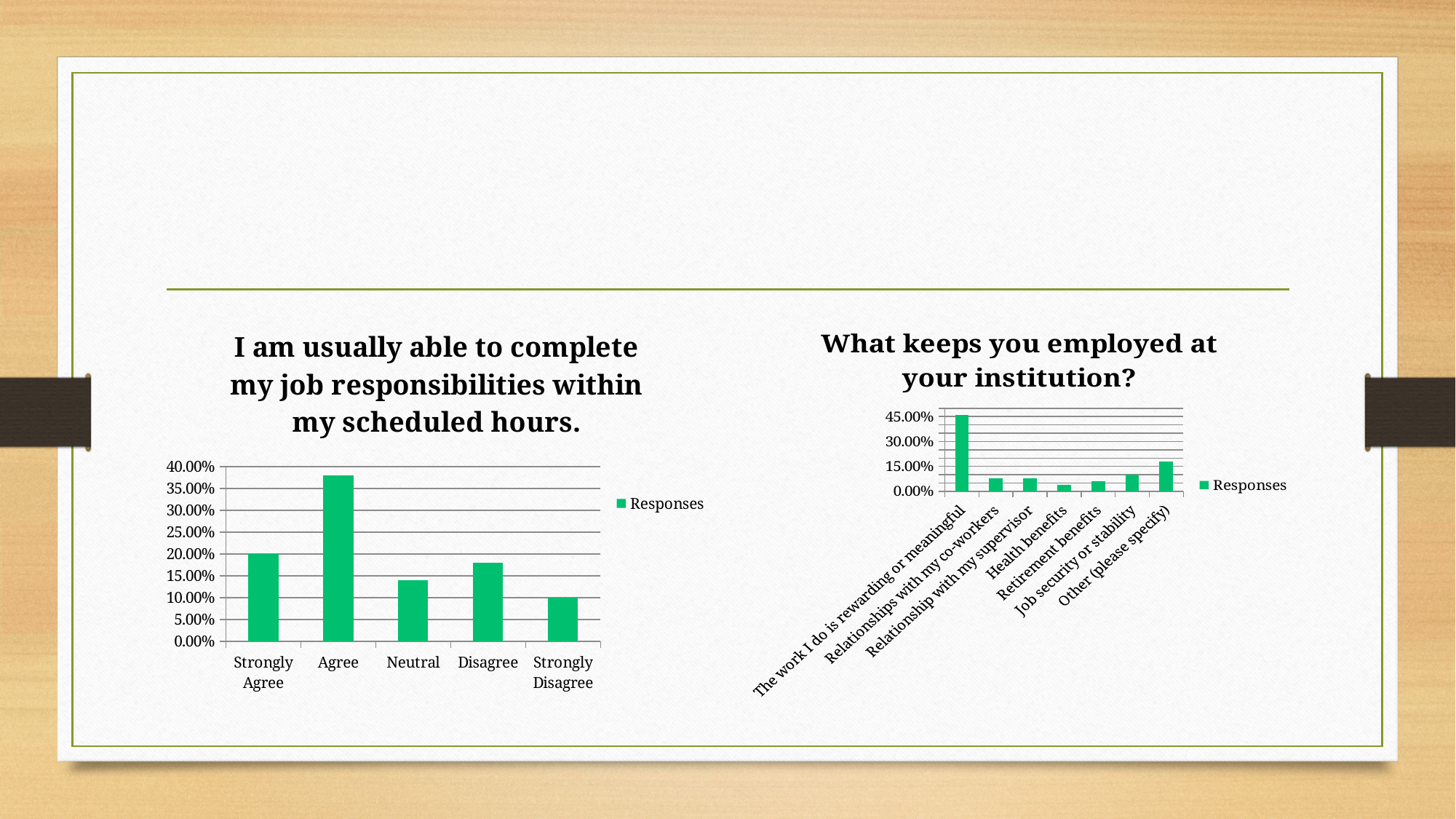
How many categories are shown on the x axis of the right chart ("What keeps you employed at your institution?")? 7 In the right chart ("What keeps you employed at your institution?"), is the value for Other (please specify) greater or less than 15.00%? greater In the left chart ("I am usually able to complete my job responsibilities within my scheduled hours."), which is larger, Strongly Agree or Disagree? Strongly Agree In the right chart ("What keeps you employed at your institution?"), which category has the highest value? The work I do is rewarding or meaningful How many series does the legend of the right chart ("What keeps you employed at your institution?") list? 1 In the right chart ("What keeps you employed at your institution?"), which category has the lowest value? Health benefits In the left chart ("I am usually able to complete my job responsibilities within my scheduled hours."), which category has the lowest value? Strongly Disagree In the left chart ("I am usually able to complete my job responsibilities within my scheduled hours."), is the value for Agree greater or less than 35.00%? greater In the left chart ("I am usually able to complete my job responsibilities within my scheduled hours."), which category has the highest value? Agree What kind of chart is the left chart titled "I am usually able to complete my job responsibilities within my scheduled hours."? bar chart How many categories are shown on the x axis of the left chart ("I am usually able to complete my job responsibilities within my scheduled hours.")? 5